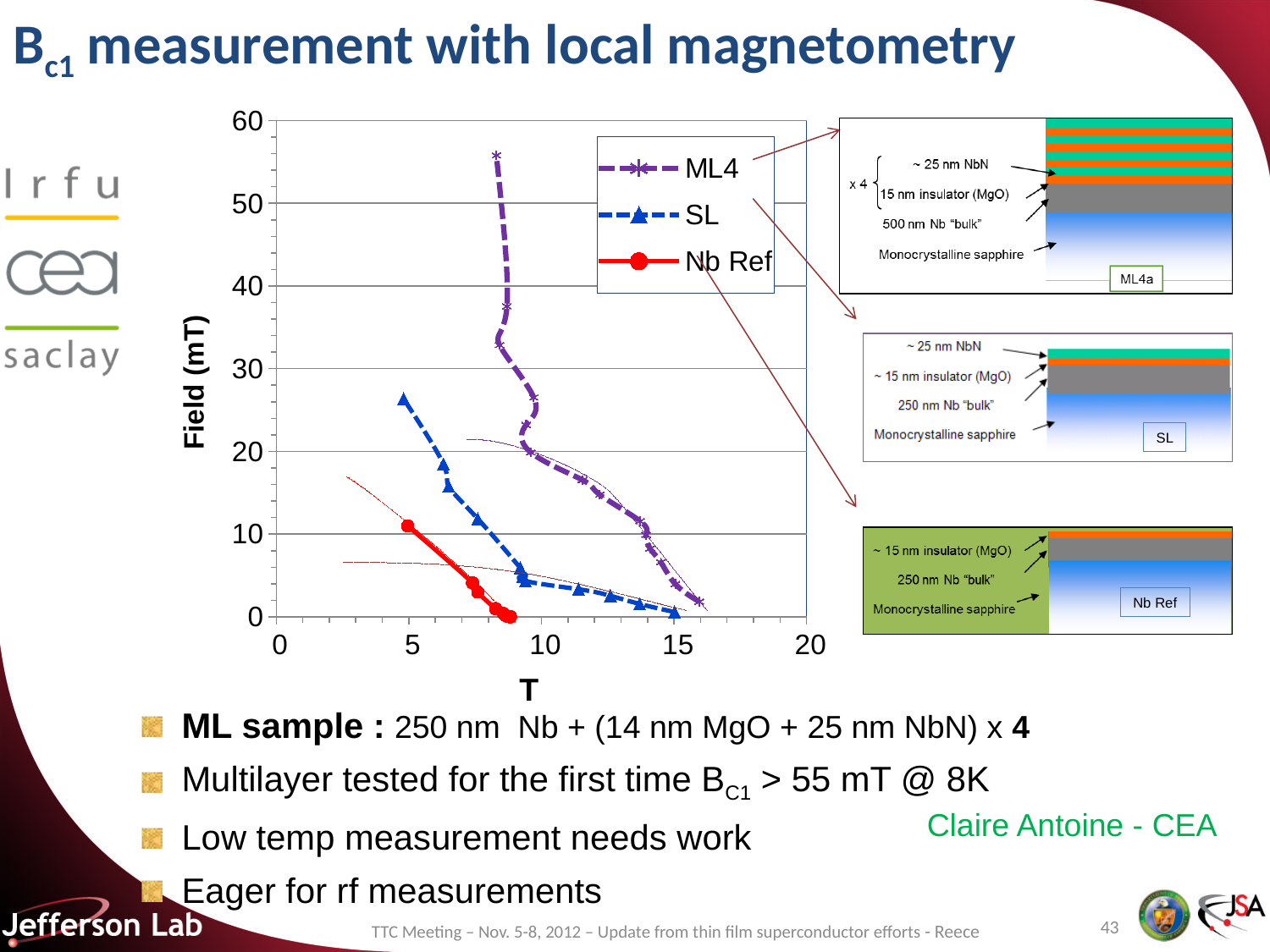
Which series has the lowest maximum field value on the chart? Nb Ref What kind of chart is shown on the slide? line chart Does the field for the SL series rise or fall as T increases? fall What is the label of the horizontal axis? T Which series reaches the highest field value on the chart? ML4 Is the highest field value reached by the Nb Ref series greater or less than 20 mT? less Is the highest field value reached by the SL series greater or less than 30 mT? less Is the highest field value reached by the ML4 series greater or less than 50 mT? greater How many series does the chart legend list? 3 What is the title of the vertical axis? Field (mT) At T = 10, which series has the higher field value, ML4 or SL? ML4 What is the highest tick value shown on the vertical axis? 60